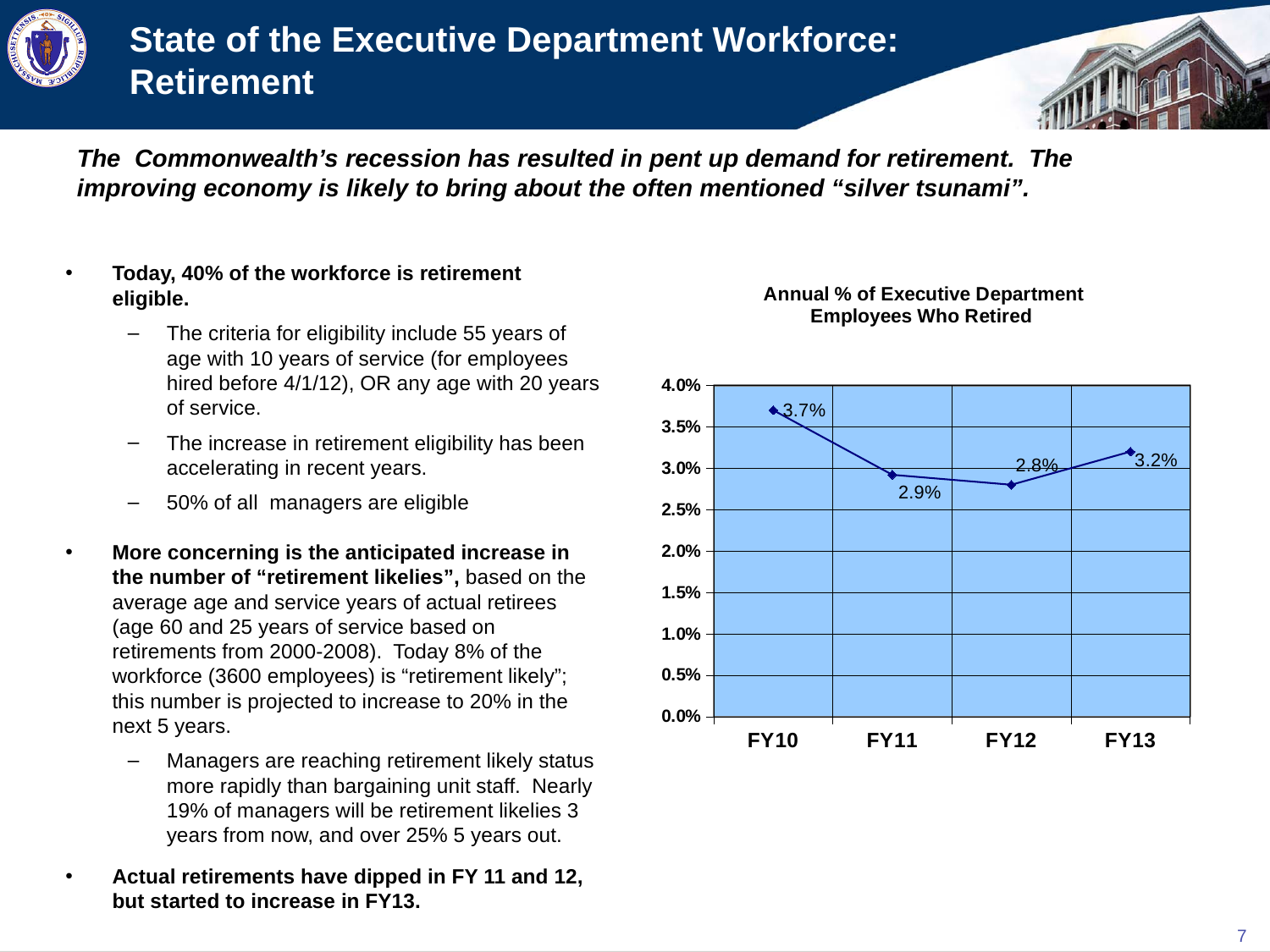
How many fiscal years are plotted on the chart? 4 What is the value for FY10? 3.7% Which fiscal year has the lowest percentage of employees who retired? FY12 What is the value for FY11? 2.9% What kind of chart is shown on the slide? line chart Which is larger, the value for FY11 or the value for FY13? FY13 What is the difference between the FY10 and FY12 values? 0.9% What is the title of the chart? Annual % of Executive Department Employees Who Retired What is the value for FY12? 2.8% What is the value for FY13? 3.2% Which fiscal year has the highest percentage of employees who retired? FY10 Is the value for FY13 greater or less than 3.0%? greater